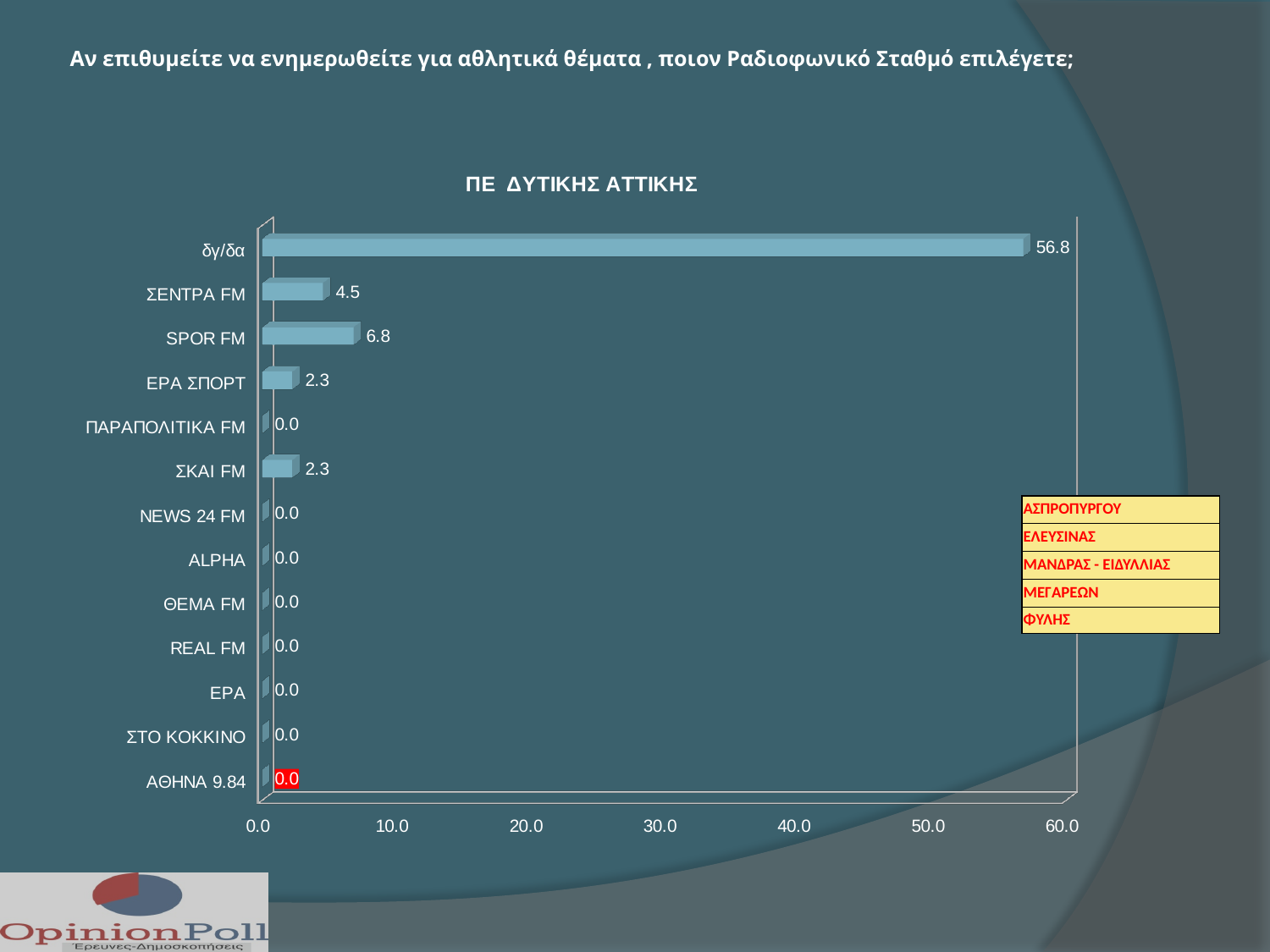
Which is larger, the value for ΣΕΝΤΡΑ FM or the value for ΕΡΑ ΣΠΟΡΤ? ΣΕΝΤΡΑ FM How many categories are shown on the chart? 13 What is the value for SPOR FM? 6.8 Which category has the highest value? δγ/δα Is the value for δγ/δα greater or less than 50.0? greater What is the difference between the values for SPOR FM and ΣΕΝΤΡΑ FM? 2.3 Which radio station (excluding δγ/δα) has the highest value? SPOR FM What is the value for ΣΕΝΤΡΑ FM? 4.5 What is the value for δγ/δα? 56.8 How many categories have a value of 0.0? 8 What kind of chart is shown on the slide? bar chart What is the value for ΣΚΑΙ FM? 2.3